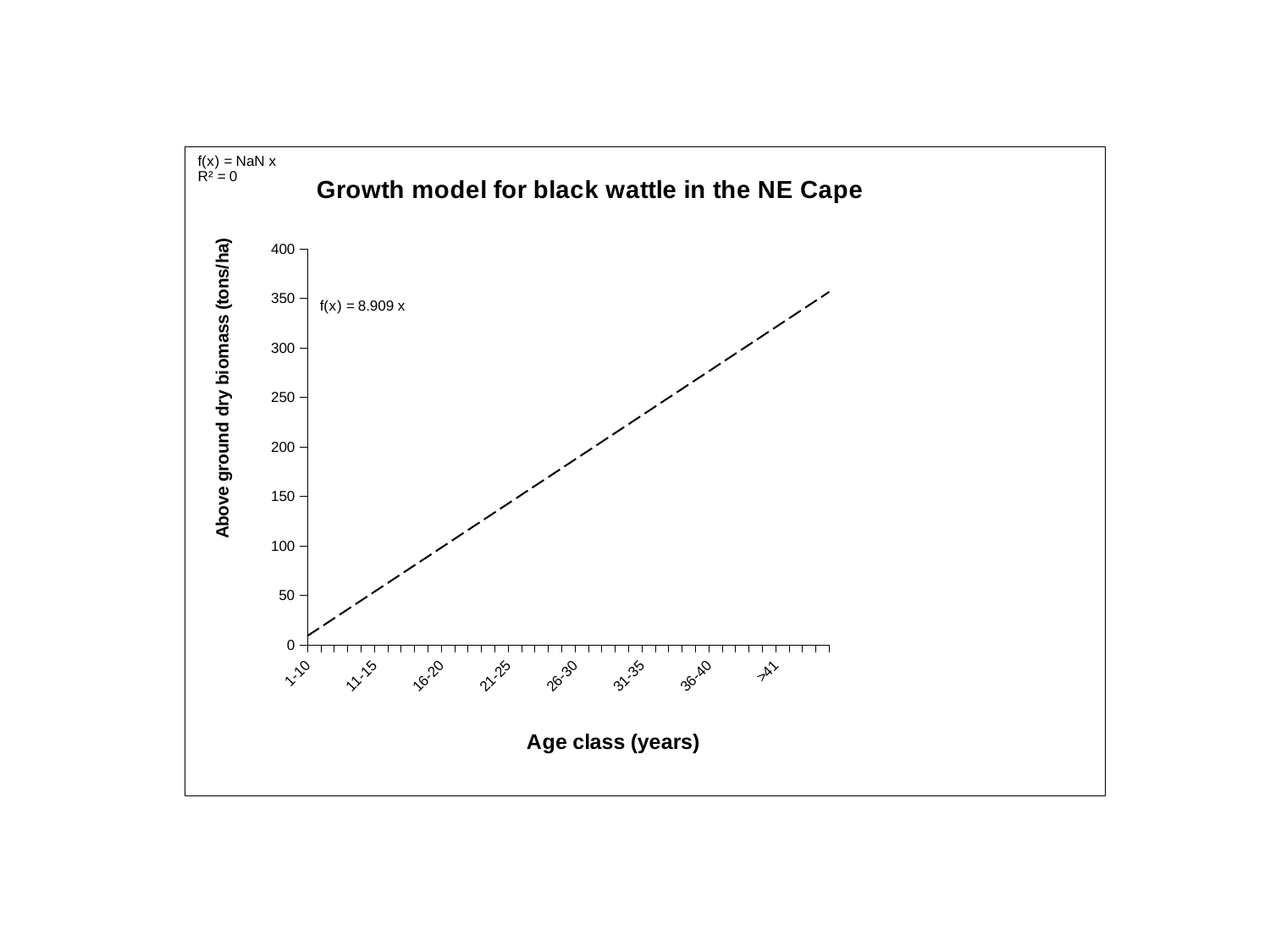
What is the label of the y axis? Above ground dry biomass (tons/ha) Do the values rise or fall as age class increases along the x axis? rise Which age class has the lowest above ground dry biomass on the line? 1-10 Is the value for the 11-15 age class greater or less than 100? less How many age class categories are labelled on the x axis? 8 What kind of chart is shown on the slide? line chart What is the title of the chart? Growth model for black wattle in the NE Cape What equation is printed next to the dashed line on the chart? f(x) = 8.909 x Is the value for the >41 age class greater or less than 250? greater Which has the larger above ground dry biomass, the 31-35 age class or the 11-15 age class? 31-35 Which age class has the highest above ground dry biomass on the line? >41 Is the value for the 26-30 age class greater or less than 150? greater